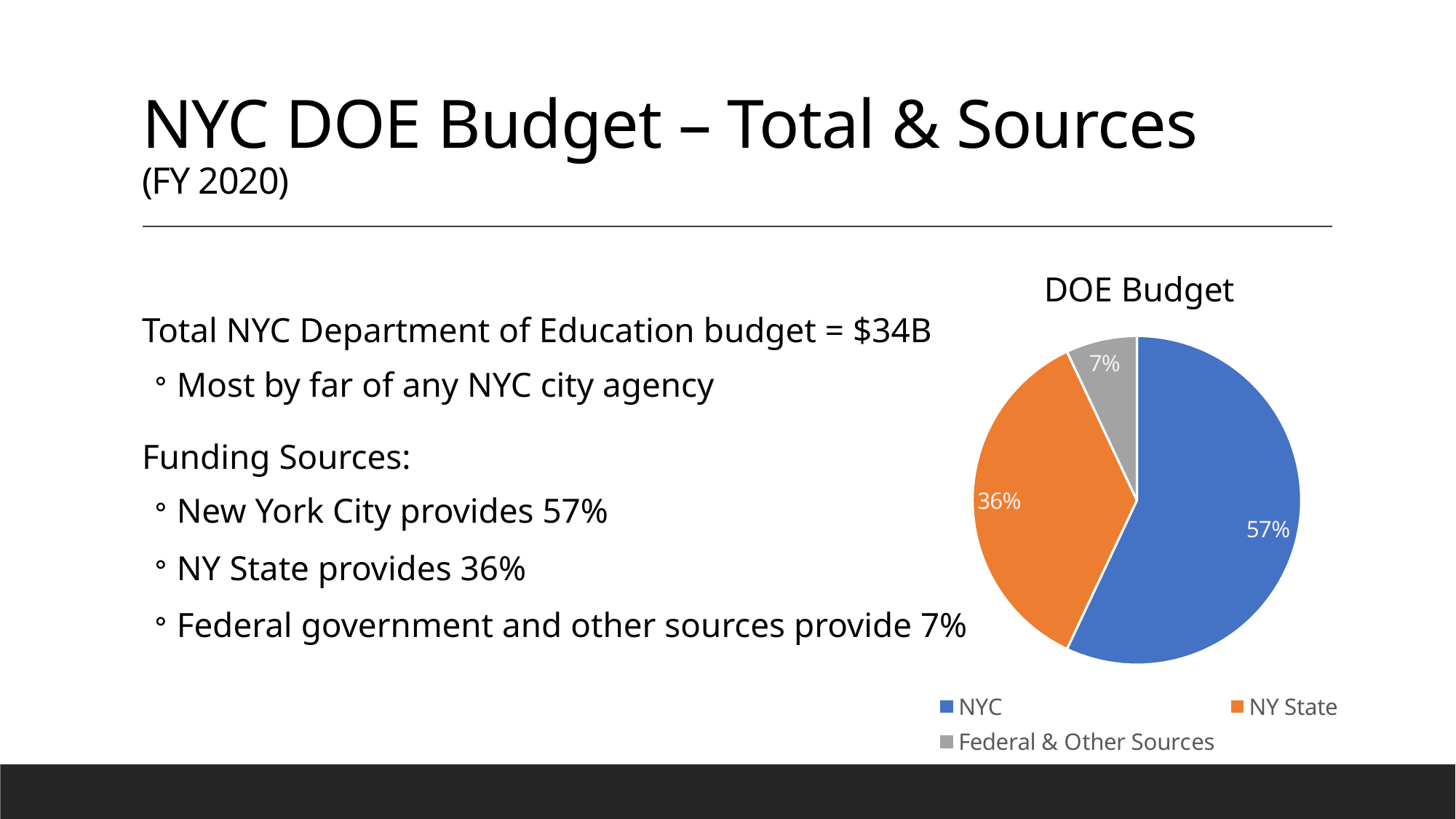
What share of the DOE Budget pie does Federal & Other Sources account for? 7% What is the title of the chart? DOE Budget What type of chart is shown on the slide? pie chart How many entries does the legend list? 3 What share of the DOE Budget pie does NY State account for? 36% What share of the DOE Budget pie does NYC account for? 57% Which funding source has the largest slice of the pie? NYC What colour is the NY State slice in the pie chart? orange How many slices does the pie chart have? 3 What is the difference in percentage points between the NYC slice and the NY State slice? 21 Which is larger, the NY State slice or the Federal & Other Sources slice? NY State Which funding source has the smallest slice of the pie? Federal & Other Sources